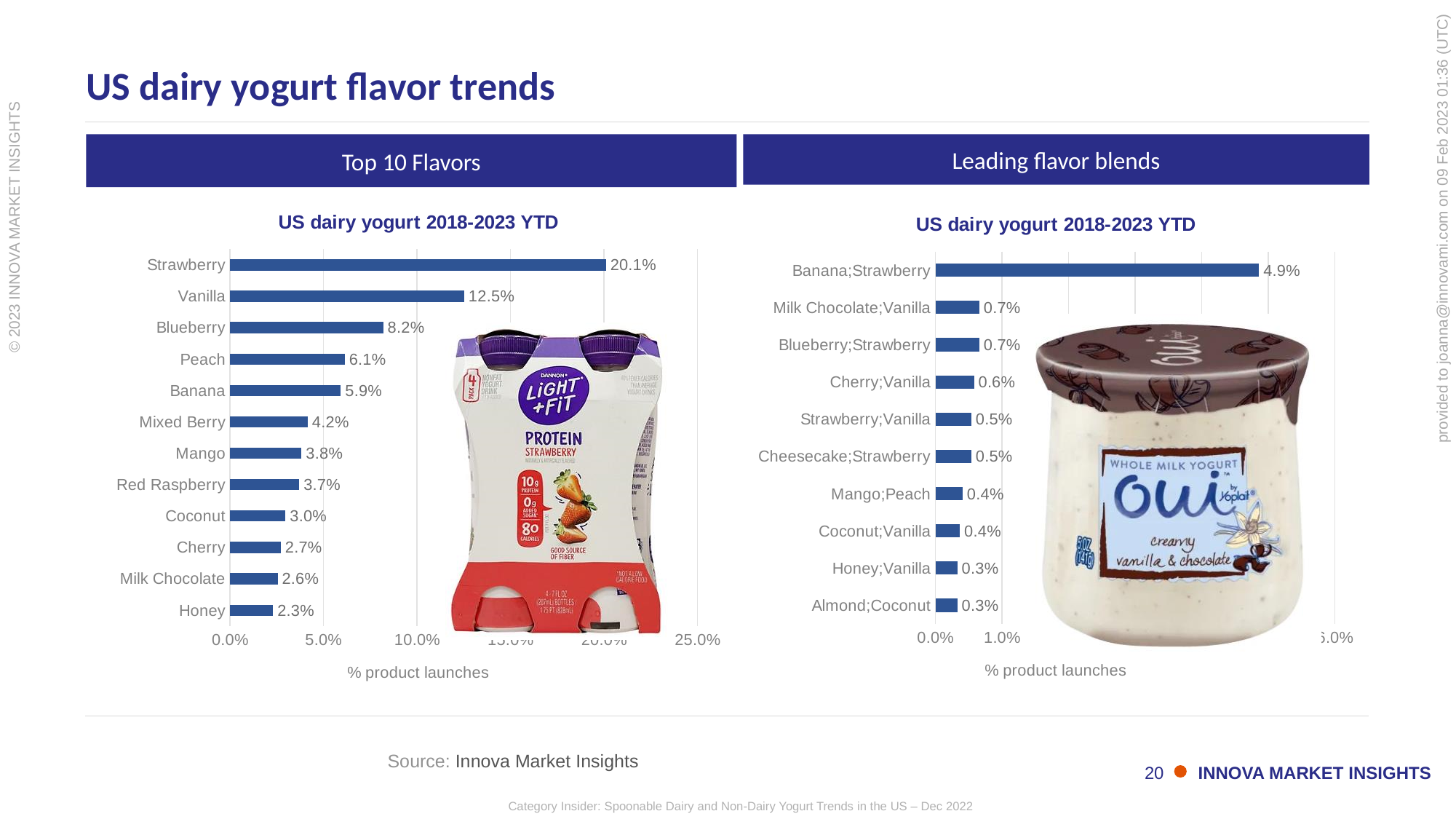
In the Leading flavor blends chart on the right, what is the value for Banana;Strawberry? 4.9% In the Top 10 Flavors chart on the left, which flavor has the lowest share of product launches? Honey What type of chart is used in the Leading flavor blends section on the right? Bar chart In the Top 10 Flavors chart on the left, what is the difference between Strawberry and Vanilla? 7.6% In the Leading flavor blends chart on the right, which blend has the highest share of product launches? Banana;Strawberry In the Leading flavor blends chart on the right, what is the value for Cherry;Vanilla? 0.6% In the Top 10 Flavors chart on the left, what is the value for Mixed Berry? 4.2% What is the x-axis label of the Top 10 Flavors chart on the left? % product launches How many flavors are plotted in the Top 10 Flavors chart on the left? 12 How many flavor blends are plotted in the Leading flavor blends chart on the right? 10 In the Top 10 Flavors chart on the left, what is the value for Strawberry? 20.1% In the Top 10 Flavors chart on the left, which is larger, Peach or Banana? Peach